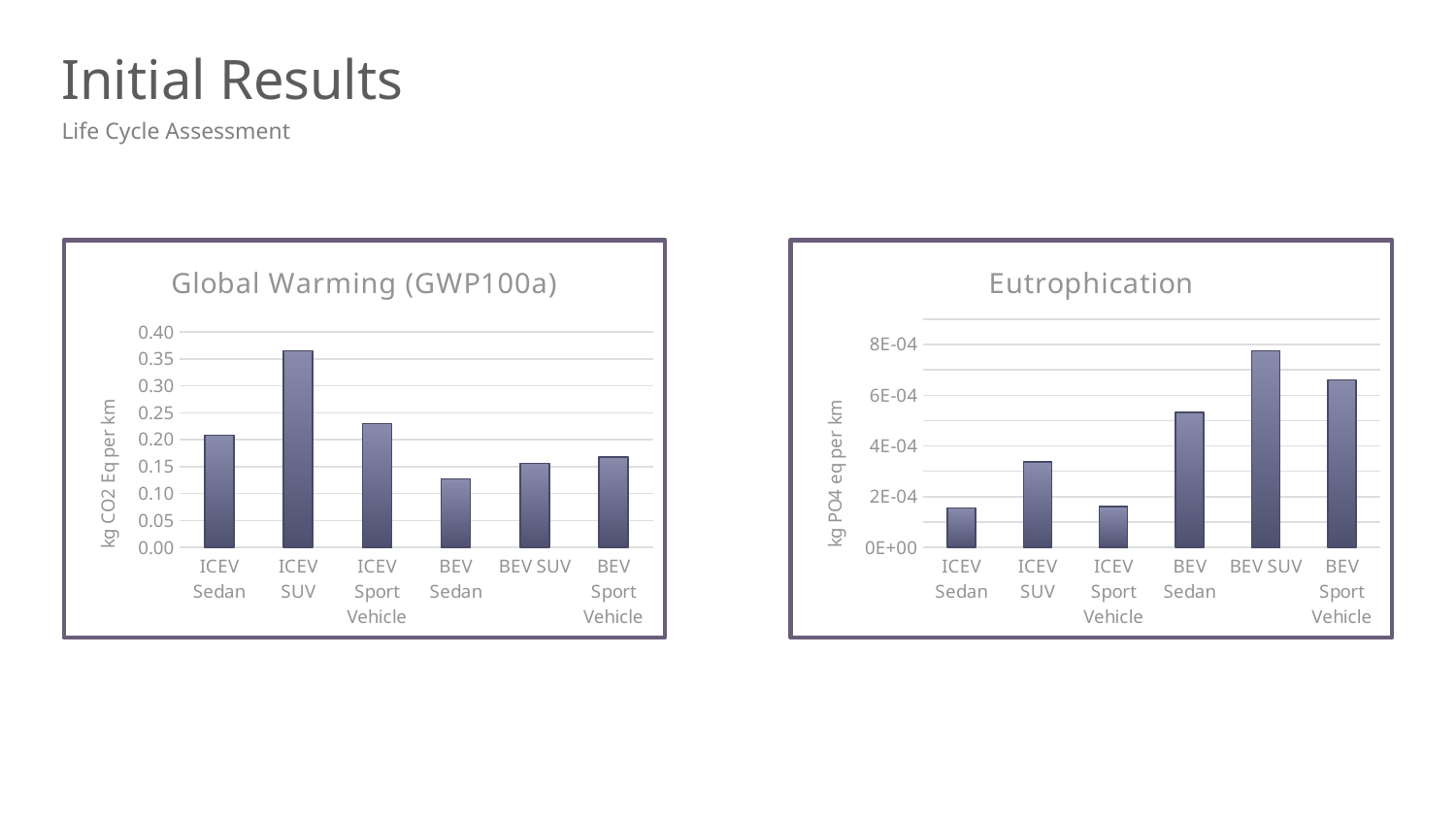
In the Global Warming (GWP100a) chart, is the value for ICEV SUV greater or less than 0.30? greater In the Eutrophication chart, is the value for BEV SUV greater or less than 6E-04? greater In the Global Warming (GWP100a) chart, which category has the lowest value? BEV Sedan In the Eutrophication chart, which category has the highest value? BEV SUV How many categories are shown in the Global Warming (GWP100a) chart? 6 In the Global Warming (GWP100a) chart, is the value for BEV Sedan greater or less than 0.15? less What kind of chart is the Eutrophication chart? bar chart In the Global Warming (GWP100a) chart, which category has the highest value? ICEV SUV What is the y-axis label of the Eutrophication chart? kg PO4 eq per km In the Global Warming (GWP100a) chart, which is larger, ICEV Sedan or BEV SUV? ICEV Sedan In the Eutrophication chart, which is larger, ICEV SUV or BEV Sedan? BEV Sedan